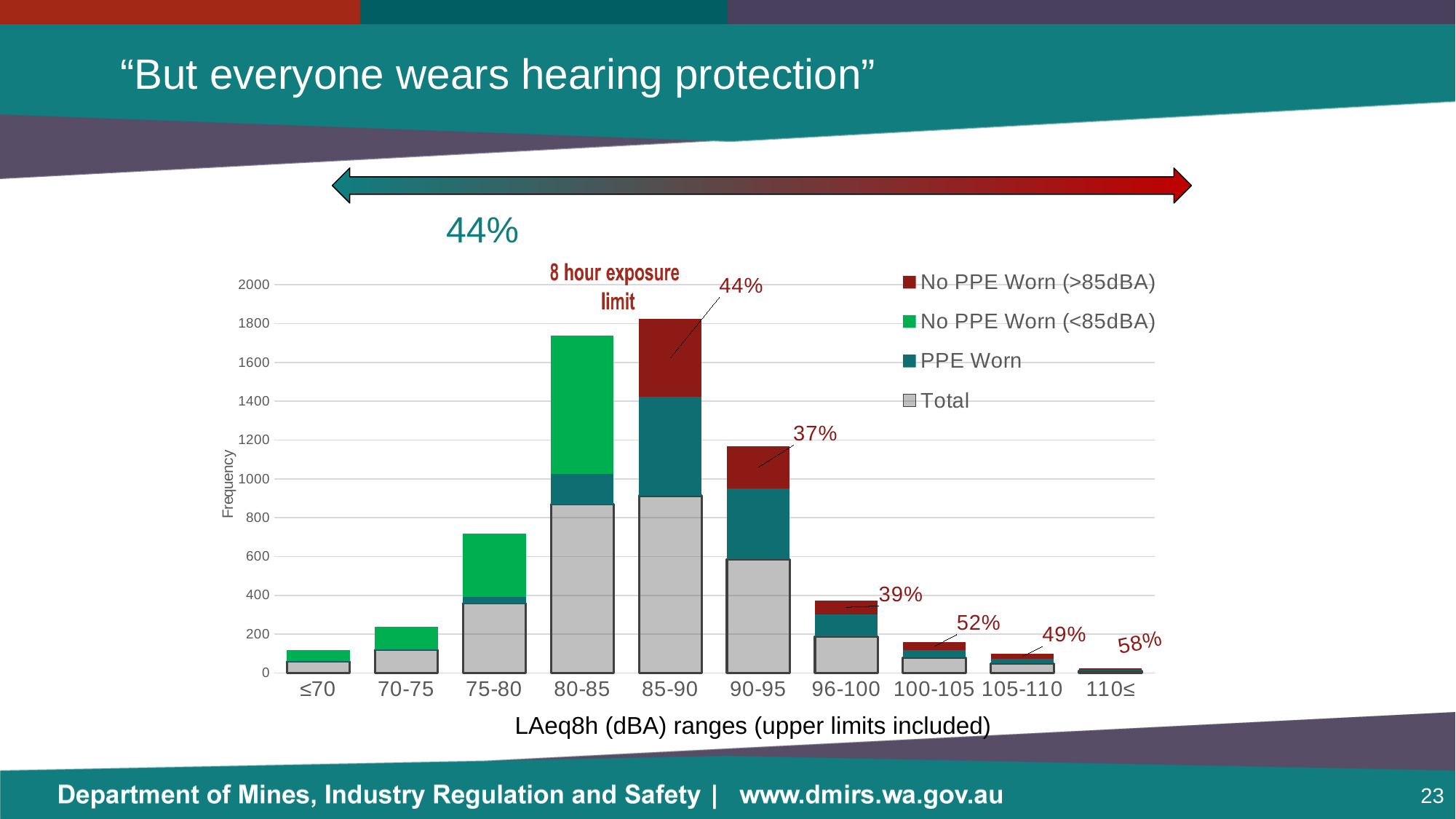
What percentage label is shown for the 85-90 range? 44% Which range has the lowest percentage label? 90-95 What percentage label is shown for the 110≤ range? 58% What is the title of the x axis? LAeq8h (dBA) ranges (upper limits included) How many LAeq8h range categories are shown on the x axis? 10 Is the total height of the 80-85 bar greater or less than 1600? greater Which range has the highest percentage label? 110≤ What kind of chart is shown on the slide? Stacked bar chart What percentage label is shown for the 90-95 range? 37% How many series does the legend list? 4 What is the difference between the percentage labels for 110≤ and 90-95? 21 percentage points Which has the larger percentage label, 100-105 or 105-110? 100-105